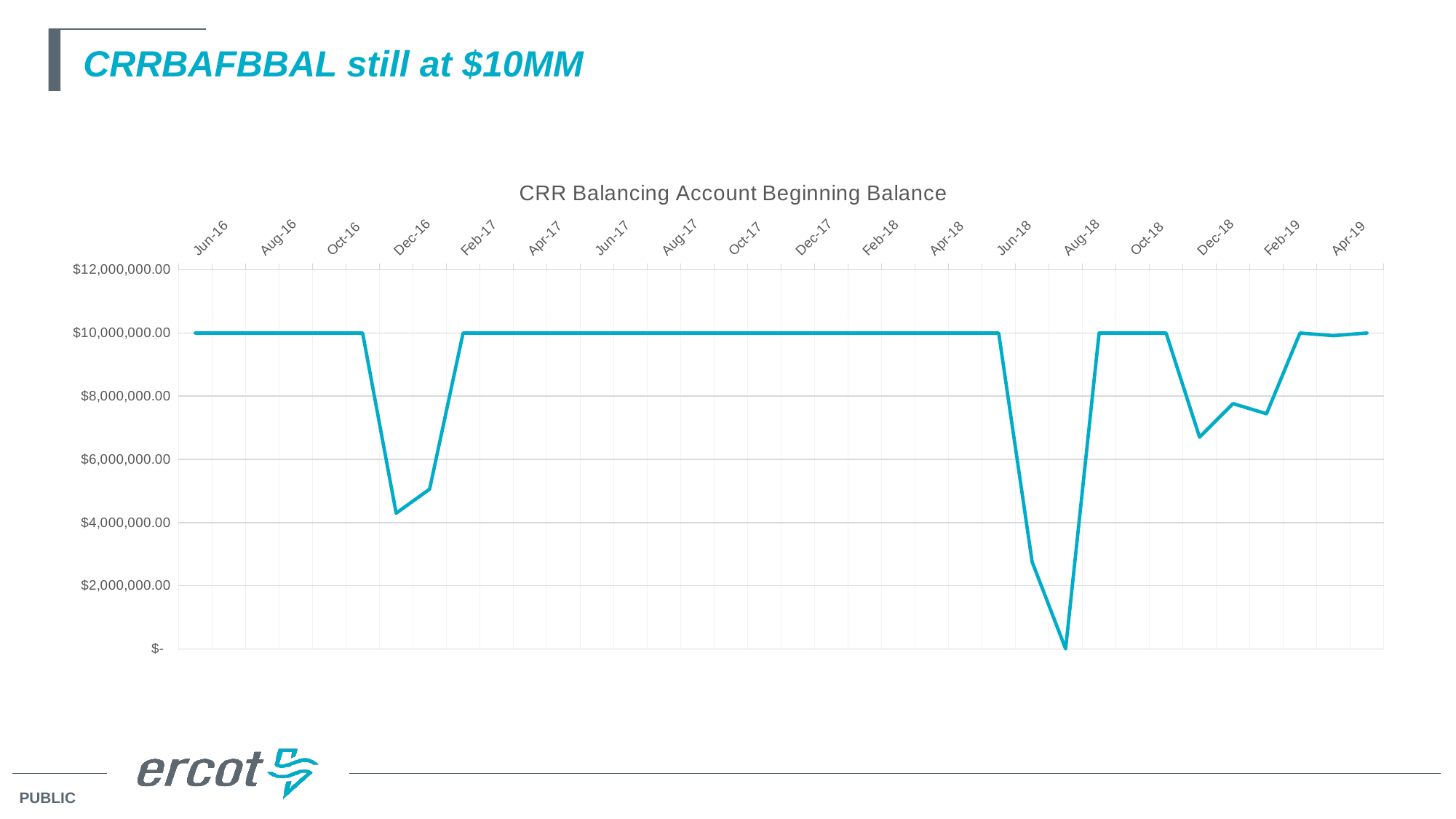
Is the value for Dec-16 greater or less than $6,000,000.00? less What is the CRR Balancing Account Beginning Balance for Feb-18? $10,000,000.00 What kind of chart is shown on the slide? Line chart Does the balance rise or fall from Oct-16 to Dec-16? Fall Is the value for Jun-18 greater or less than $8,000,000.00? greater Which is larger, the value for Dec-16 or the value for Dec-18? Dec-18 How many month labels are shown on the x axis? 18 What is the title of the chart? CRR Balancing Account Beginning Balance What is the CRR Balancing Account Beginning Balance for Jun-16? $10,000,000.00 Which month has the lowest CRR Balancing Account Beginning Balance? Aug-18 Is the value for Feb-19 greater or less than $8,000,000.00? less